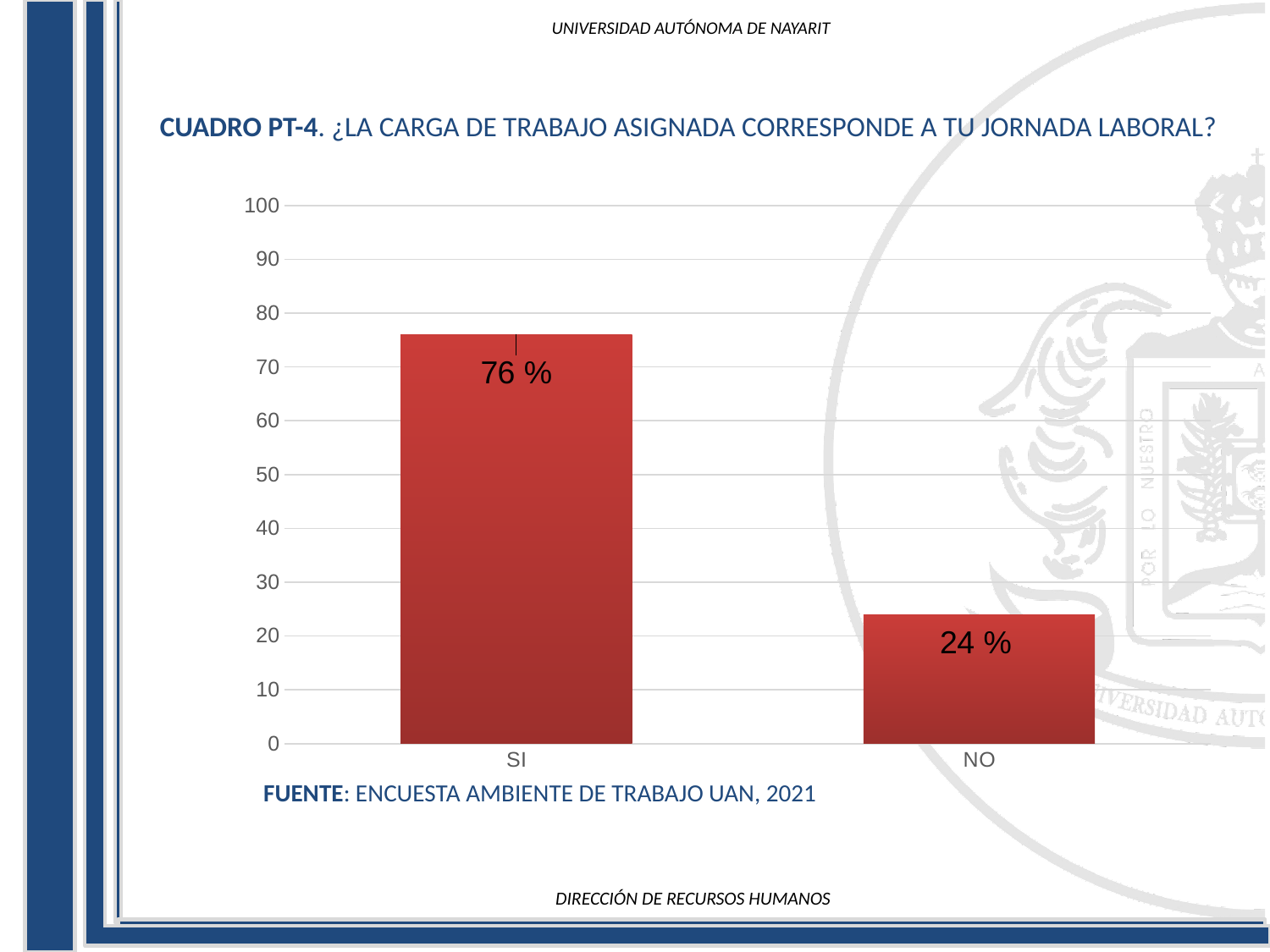
What is the difference between the values for SI and NO? 52 % Which category has the lowest value? NO Is the value for NO greater or less than 30? less How many categories are shown on the x axis? 2 What kind of chart is shown on the slide? bar chart What is the highest value shown on the vertical axis? 100 What is the value for NO? 24 % Which category has the highest value? SI Is the value for SI greater or less than 70? greater What is the value for SI? 76 % What source is cited below the chart? ENCUESTA AMBIENTE DE TRABAJO UAN, 2021 Which is larger, the value for SI or the value for NO? SI